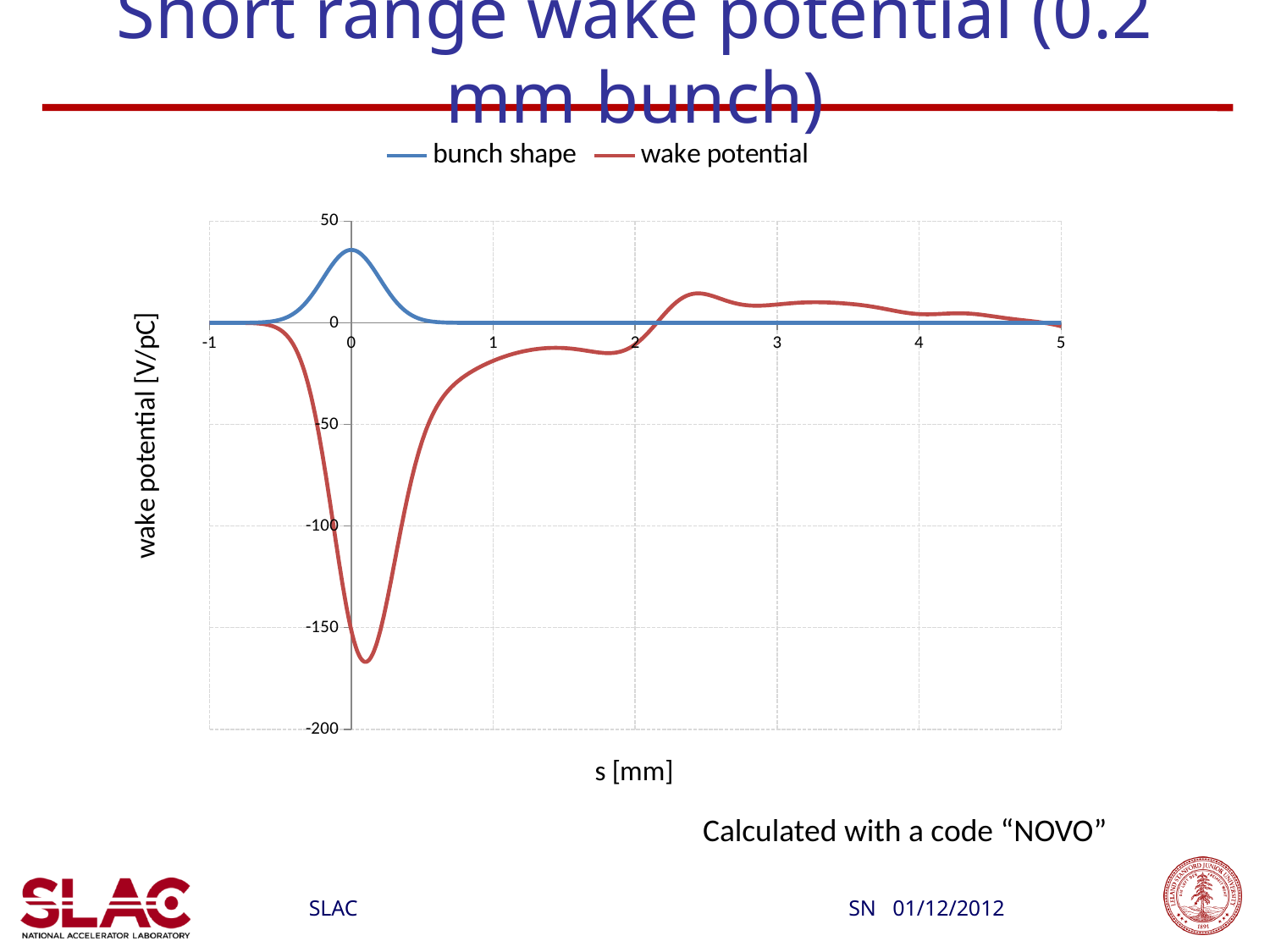
Is the minimum value of the wake potential curve greater or less than -150? less What kind of chart is shown on the slide? line chart Is the wake potential at s = 1 mm greater or less than -50? greater How many series does the legend list? 2 Does the wake potential curve rise or fall between s = 0.2 mm and s = 1 mm? rise At s = 0 mm, which series has the larger value, bunch shape or wake potential? bunch shape How many labelled tick marks are on the x axis? 7 What are the two series named in the legend? bunch shape, wake potential Does the bunch shape curve rise or fall between s = 0 mm and s = 0.5 mm? fall What is the label of the x axis? s [mm] Is the peak value of the bunch shape curve greater or less than 50? less